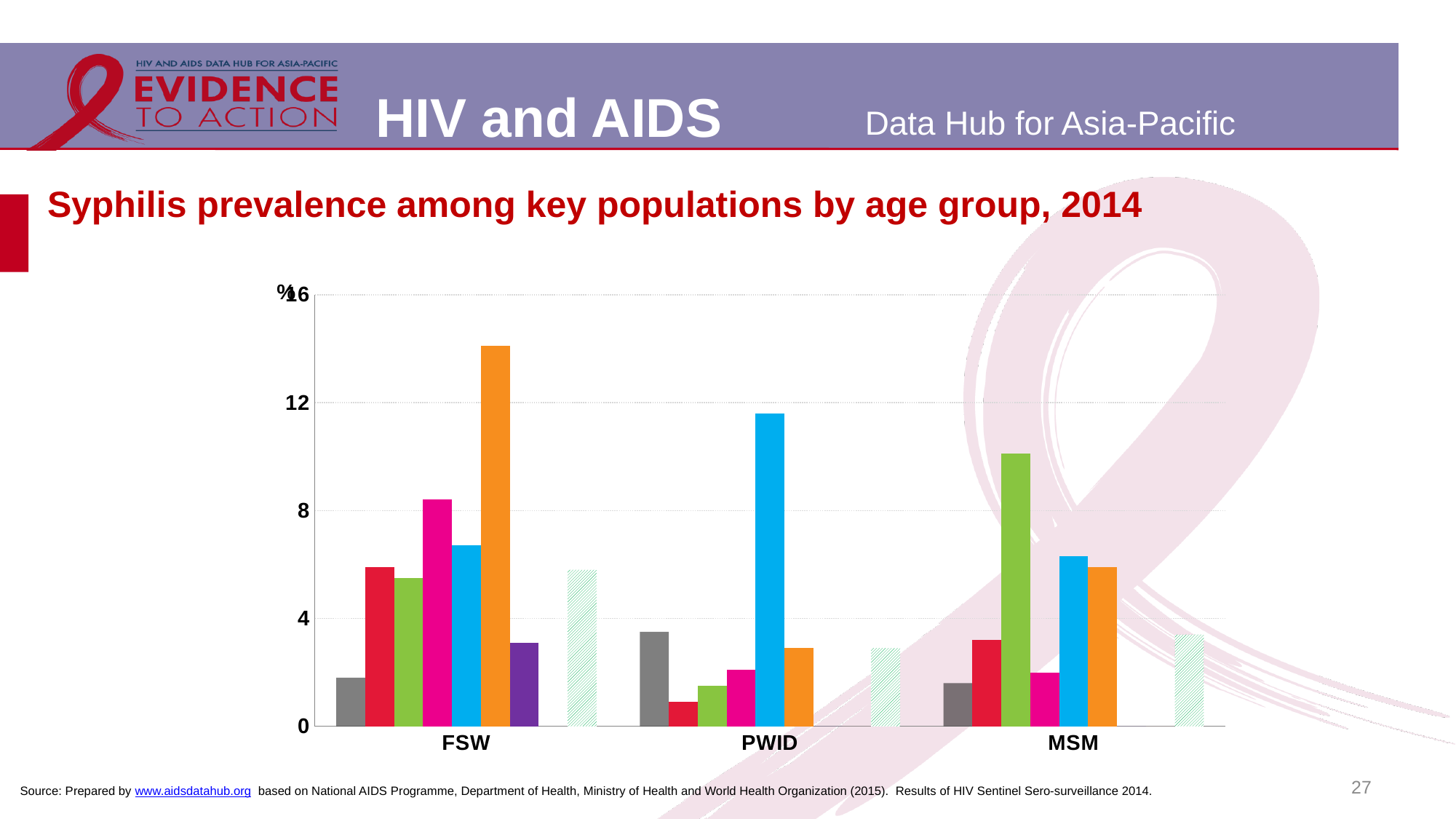
Is the value of the orange bar for FSW greater or less than 12? greater Is the value of the blue bar for PWID greater or less than 8? greater How many key population categories are shown on the x axis? 3 What is the title of the chart on the slide? Syphilis prevalence among key populations by age group, 2014 For FSW, which bar is taller: the orange bar or the purple bar? orange Which key population category contains the tallest bar in the chart? FSW Is the value of the grey bar for FSW greater or less than 4? less For MSM, which bar is taller: the green bar or the pink bar? green What kind of chart is shown on the slide? bar chart What unit is shown on the y axis of the chart? %